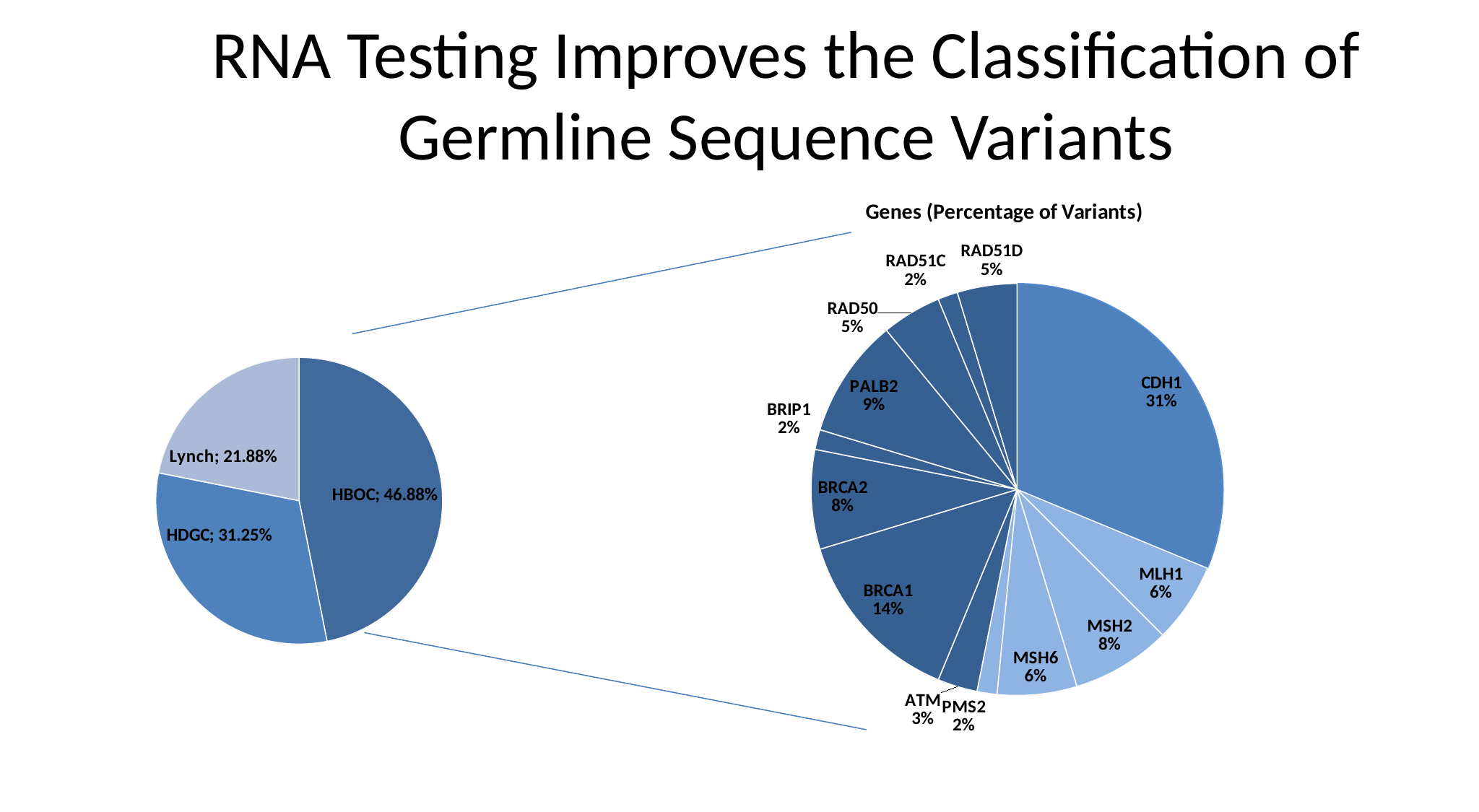
In the 'Genes (Percentage of Variants)' pie chart, which is larger, BRCA2 or MLH1? BRCA2 In the 'Genes (Percentage of Variants)' pie chart, which gene has the largest slice? CDH1 What type of chart is used on the right side of the slide? Pie chart In the 'Genes (Percentage of Variants)' pie chart, how many gene slices are there? 13 In the left pie chart, how many slices are there? 3 In the 'Genes (Percentage of Variants)' pie chart, what percentage is shown for PALB2? 9% In the 'Genes (Percentage of Variants)' pie chart, what is the difference between the CDH1 and BRCA1 percentages? 17% In the left pie chart, which category has the largest slice? HBOC In the left pie chart, which category has the smallest slice? Lynch In the 'Genes (Percentage of Variants)' pie chart, what percentage is shown for BRCA1? 14% In the left pie chart, what percentage is shown for Lynch? 21.88% In the left pie chart, what percentage is shown for HBOC? 46.88%